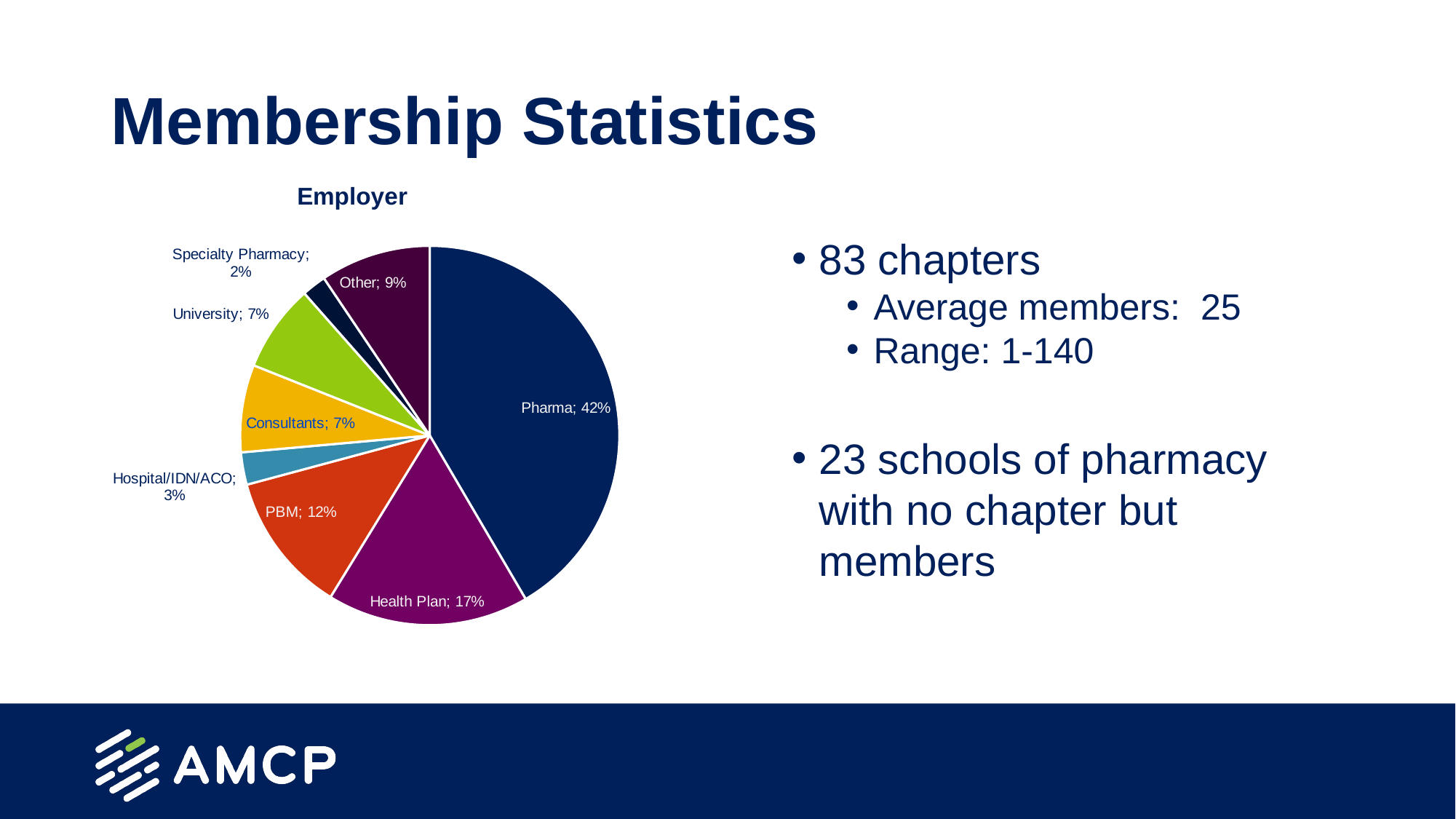
What is the value for Health Plan? 17% What is the difference between the Pharma and Health Plan shares? 25% What is the title of the chart? Employer What type of chart is shown on the slide? pie chart Which employer category has the smallest share? Specialty Pharmacy What share of the pie does Pharma represent? 42% How many categories are shown in the pie chart? 8 Which is larger, the share for PBM or the share for Other? PBM What is the value for PBM? 12% Which employer category has the largest share? Pharma What is the difference between the University and Specialty Pharmacy shares? 5% What is the value for Hospital/IDN/ACO? 3%